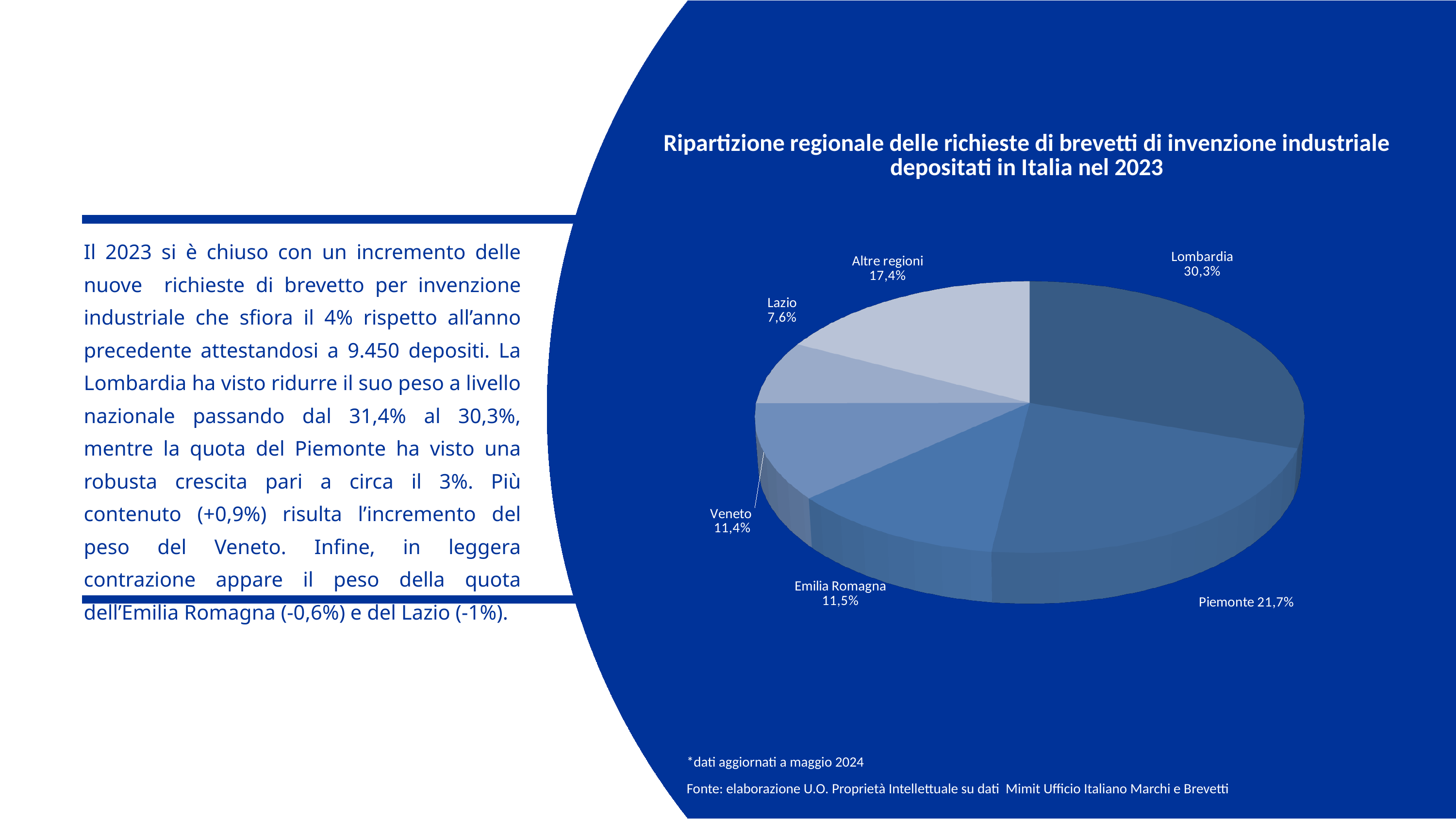
What share of the pie is labelled Altre regioni? 17,4% Which region has the largest slice of the pie? Lombardia What type of chart is shown on the slide? pie chart What is the value shown for Veneto? 11,4% Which is larger, the share of Altre regioni or the share of Lazio? Altre regioni What is the value shown for Lazio? 7,6% What share of the pie does Lombardia hold? 30,3% What is the value shown for Emilia Romagna? 11,5% Which slice of the pie is the smallest? Lazio How many slices does the pie chart have? 6 What is the value shown for Piemonte? 21,7% What is the difference between the shares of Lombardia and Piemonte? 8,6%